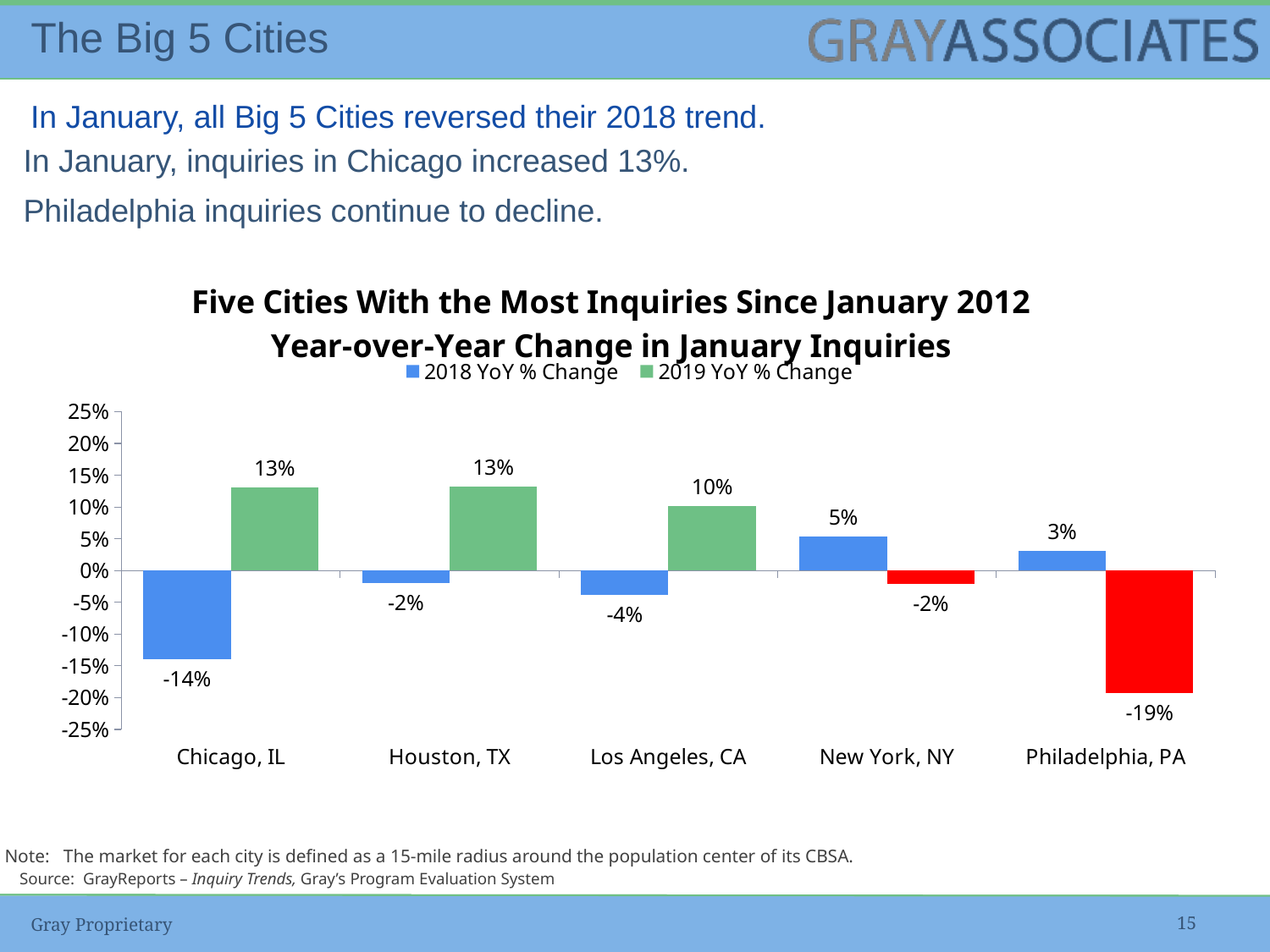
What type of chart is shown on the slide? Bar chart How many cities are shown on the x axis of the chart? 5 Which city has the lowest 2019 YoY % Change? Philadelphia, PA How many series does the chart legend list? 2 What is the 2019 YoY % Change for Chicago, IL? 13% Which is larger for Houston, TX: the 2018 YoY % Change or the 2019 YoY % Change? 2019 YoY % Change Which city has the lowest 2018 YoY % Change? Chicago, IL What is the 2019 YoY % Change for Los Angeles, CA? 10% What is the 2018 YoY % Change for New York, NY? 5% Which city has the highest 2018 YoY % Change? New York, NY What is the difference between the 2019 and 2018 YoY % Change for Chicago, IL? 27 percentage points What is the 2018 YoY % Change for Philadelphia, PA? 3%